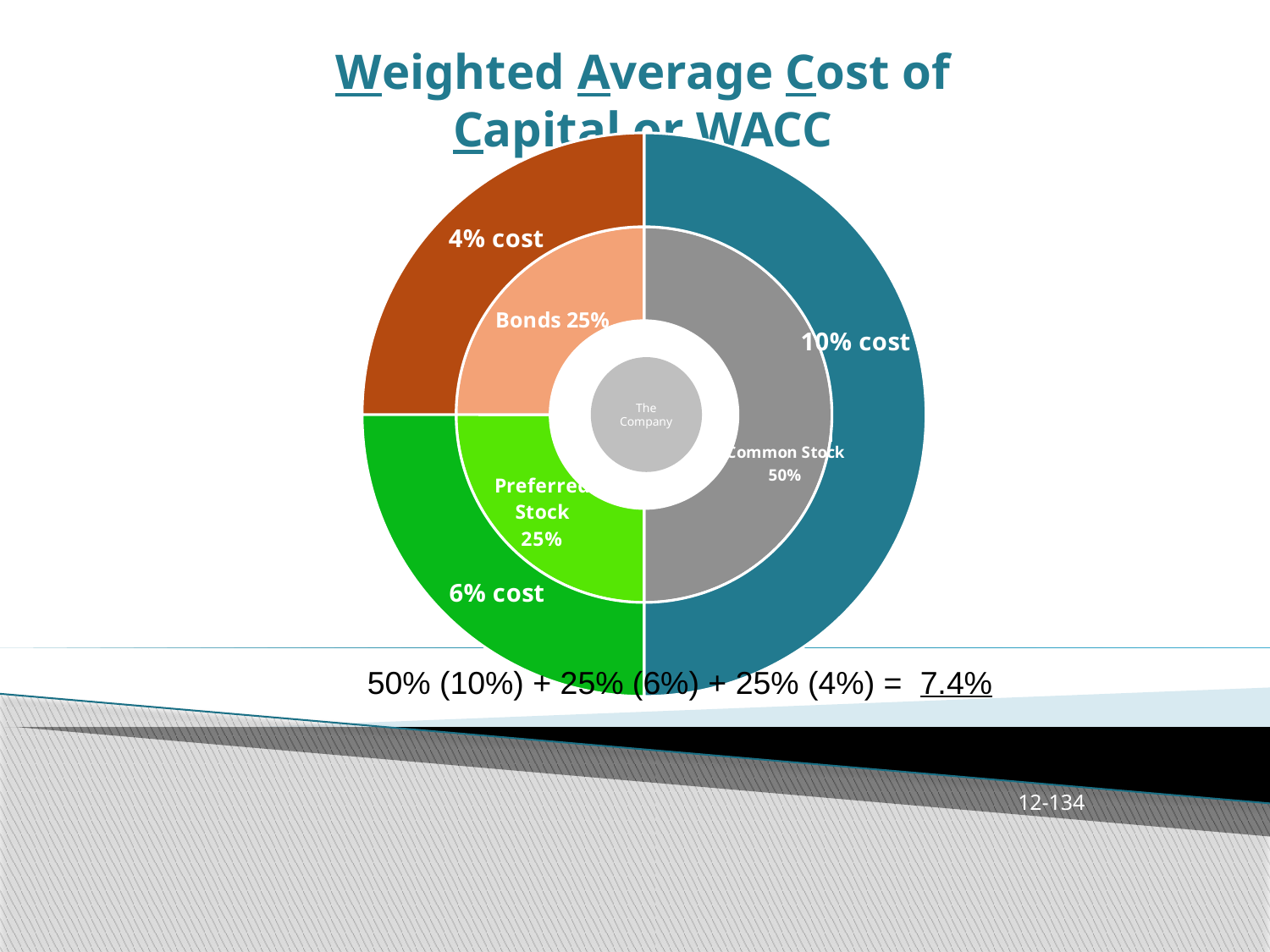
What is the cost shown for Preferred Stock in the outer ring? 6% cost How many capital sources are shown in the chart? 3 What share of the company's capital is Common Stock? 50% Which capital source has the highest cost? Common Stock What is the cost shown for Common Stock in the outer ring? 10% cost What is the difference between the share of Common Stock and the share of Bonds? 25% What share of the company's capital is Preferred Stock? 25% Which capital source has the largest share of the company's capital? Common Stock What share of the company's capital is Bonds? 25% What is the weighted average cost of capital shown below the chart? 7.4% Which capital source has the lowest cost? Bonds What is the cost shown for Bonds in the outer ring? 4% cost